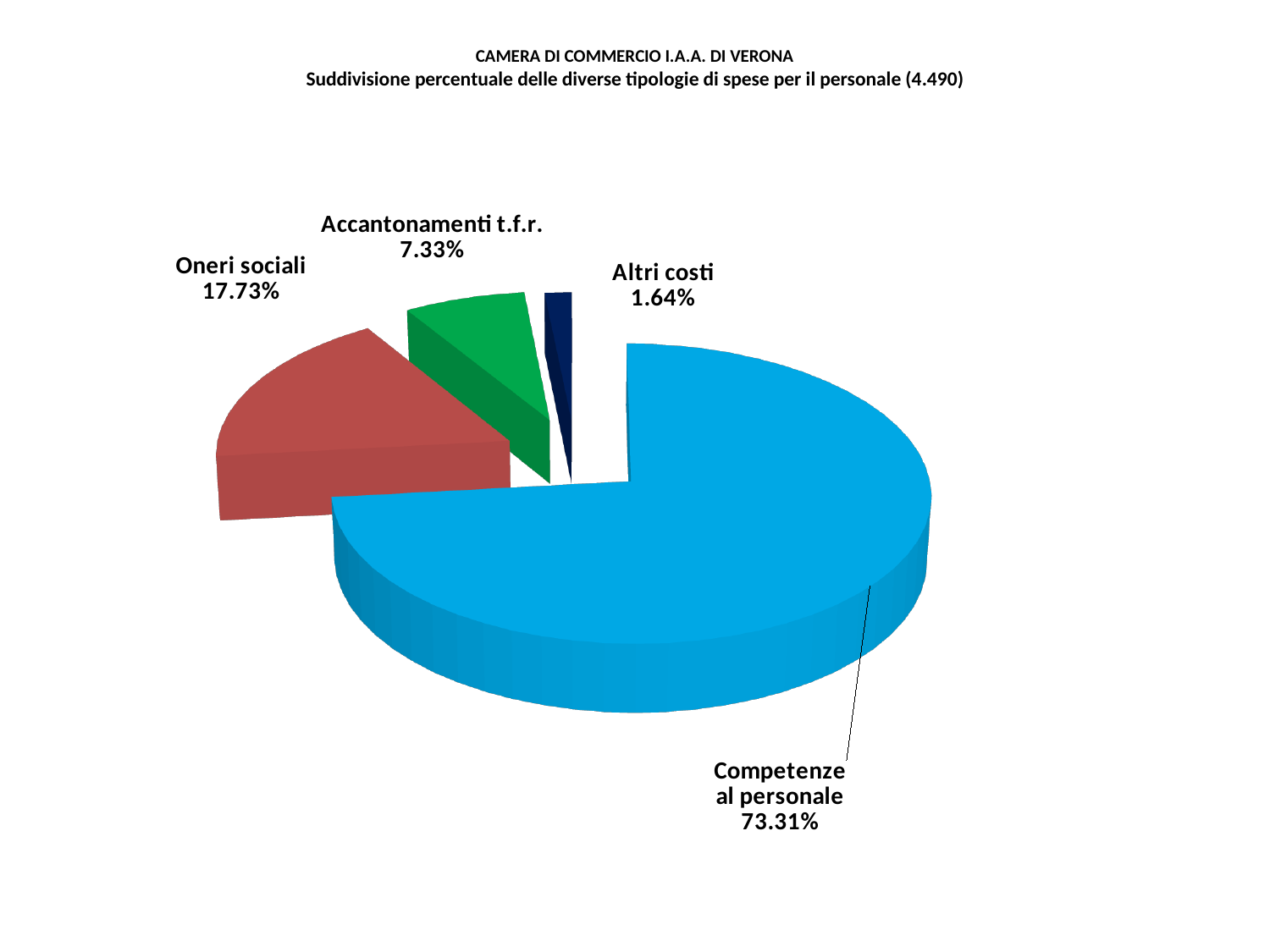
How many slices does the pie chart have? 4 What percentage is shown for Competenze al personale? 73.31% What percentage is shown for Altri costi? 1.64% What kind of chart is shown on the slide? pie chart Which category has the largest share of the pie? Competenze al personale What colour is the slice for Oneri sociali? red Which category has the smallest share of the pie? Altri costi What is the difference in percentage points between Oneri sociali and Accantonamenti t.f.r.? 10.40 What is the difference in percentage points between Competenze al personale and Oneri sociali? 55.58 What percentage is shown for Accantonamenti t.f.r.? 7.33% Which is larger, Oneri sociali or Accantonamenti t.f.r.? Oneri sociali What percentage is shown for Oneri sociali? 17.73%